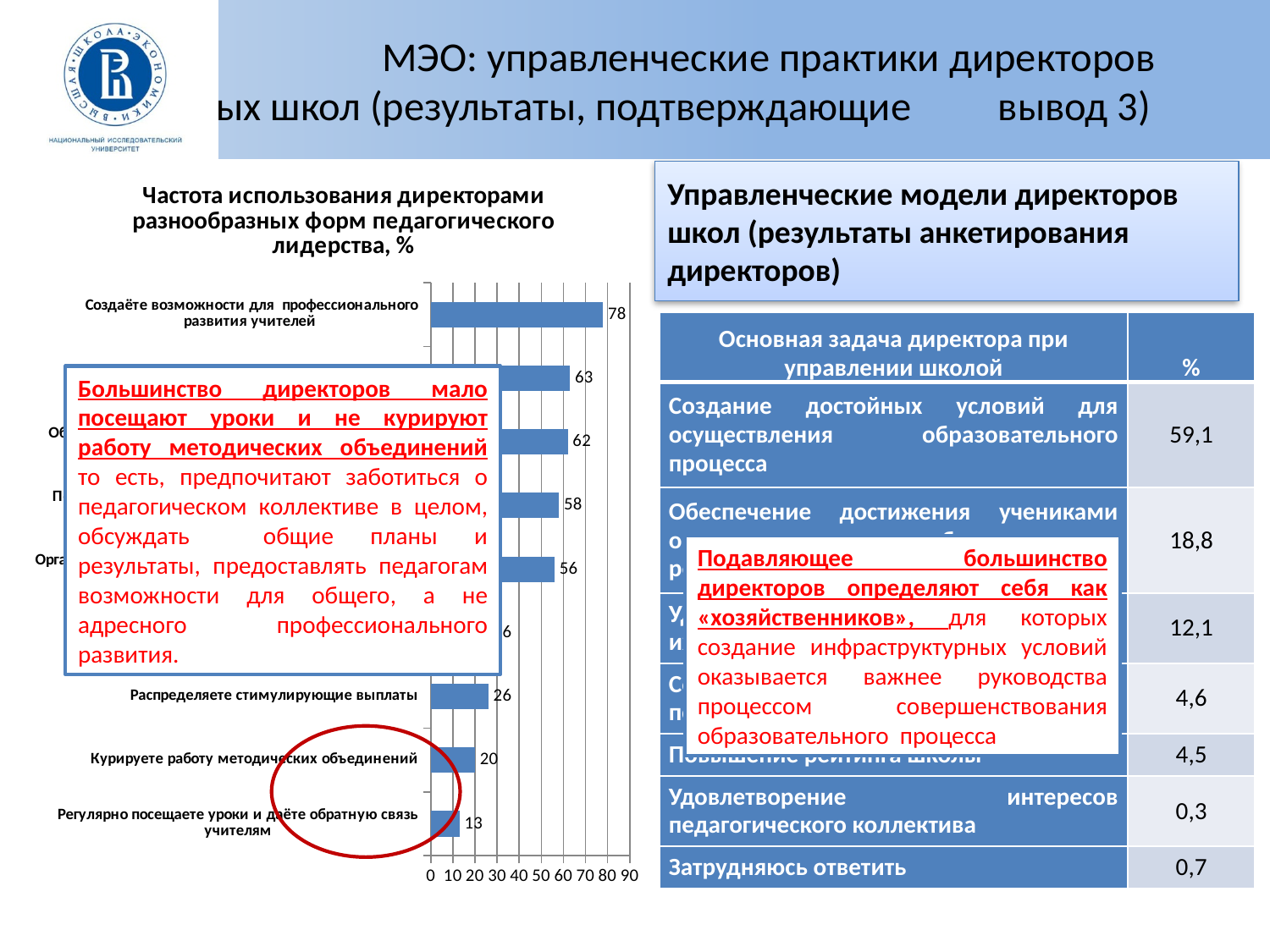
Which is larger in the chart: "Распределяете стимулирующие выплаты" or "Курируете работу методических объединений"? Распределяете стимулирующие выплаты Which category in the chart has the highest value? Создаёте возможности для профессионального развития учителей In the chart, what is the value for "Создаёте возможности для профессионального развития учителей"? 78 What kind of chart is shown on the slide? Bar chart In the chart, what is the value for "Регулярно посещаете уроки и даёте обратную связь учителям"? 13 Is the value for "Создаёте возможности для профессионального развития учителей" greater or less than 70? greater Which category in the chart has the lowest value? Регулярно посещаете уроки и даёте обратную связь учителям In the chart, what is the value for "Распределяете стимулирующие выплаты"? 26 What is the difference between the values for "Создаёте возможности для профессионального развития учителей" and "Регулярно посещаете уроки и даёте обратную связь учителям"? 65 What is the difference between the values for "Распределяете стимулирующие выплаты" and "Курируете работу методических объединений"? 6 In the chart, what is the value for "Курируете работу методических объединений"? 20 How many bars are plotted in the chart? 9